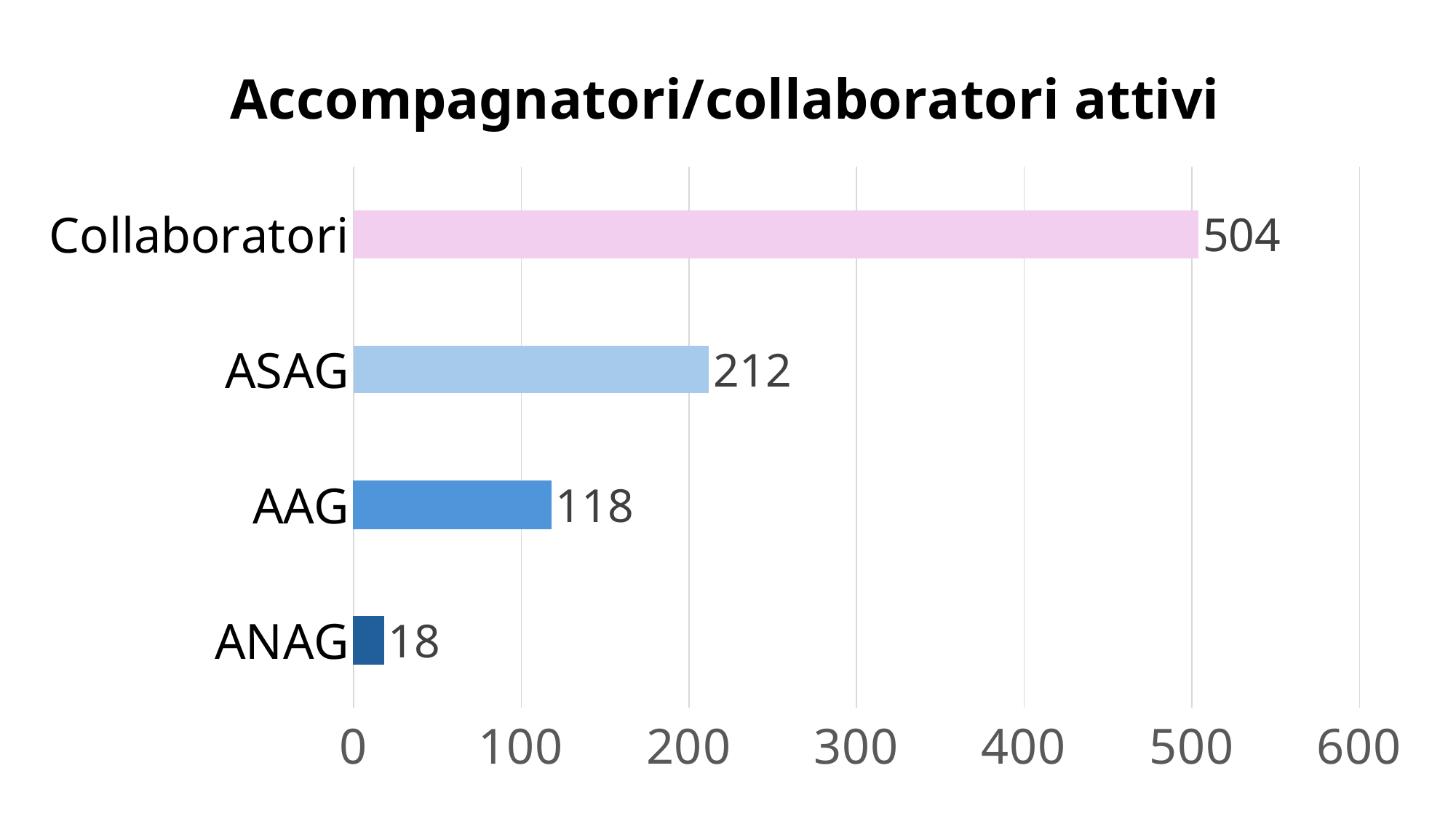
What is the difference between the values for Collaboratori and ASAG? 292 What is the value for ASAG? 212 What is the value for ANAG? 18 Which category has the highest value? Collaboratori What is the value for AAG? 118 What is the title of the chart? Accompagnatori/collaboratori attivi What is the difference between the values for AAG and ANAG? 100 What is the value for Collaboratori? 504 How many categories are shown in the chart? 4 Which is larger, the value for ASAG or the value for AAG? ASAG What kind of chart is this? Bar chart Which category has the lowest value? ANAG